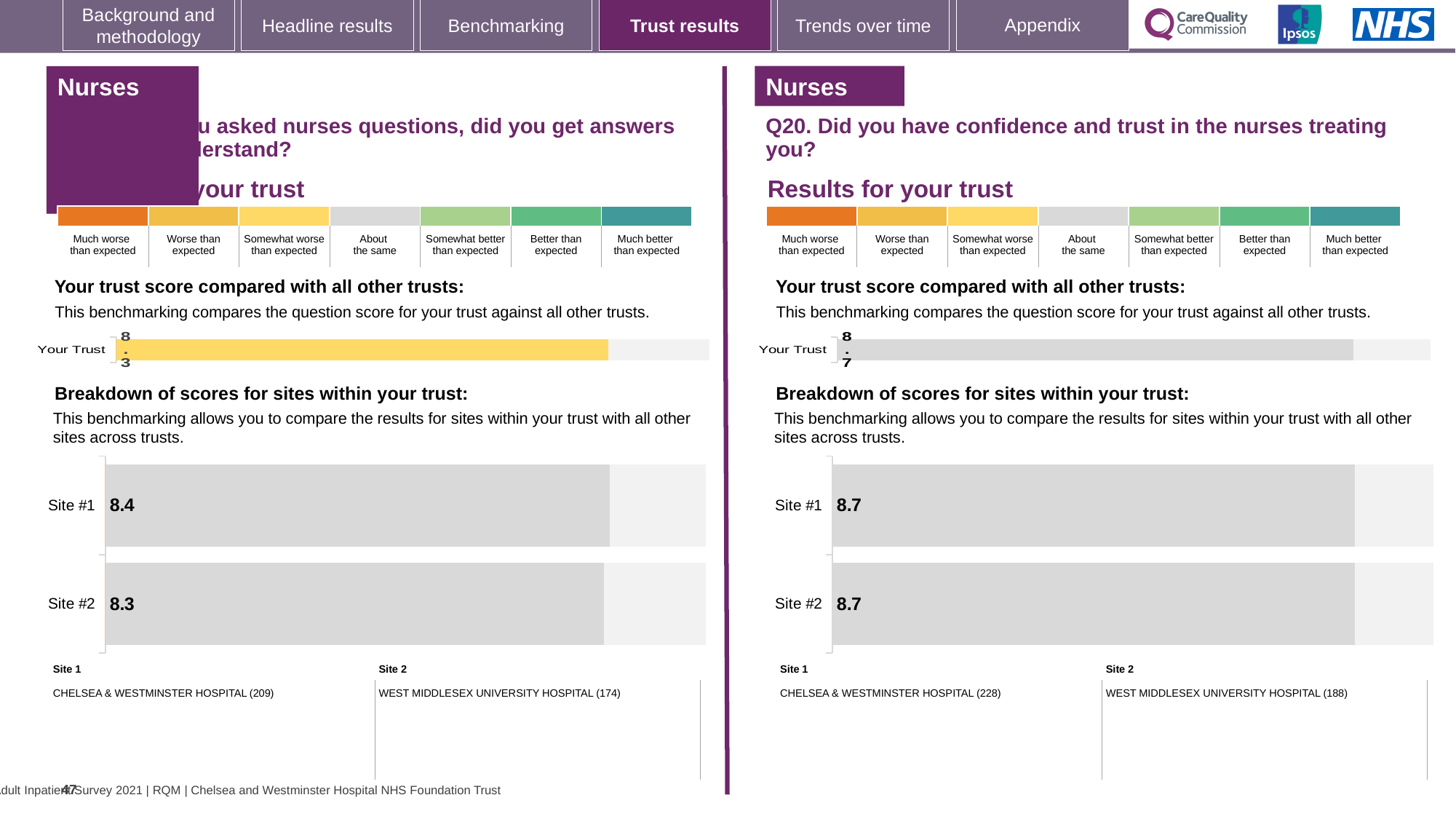
What colour is the Your Trust bar in the left-hand trust score chart? Yellow What type of chart is used for the breakdown of scores for sites on the right half of the slide? Bar chart On the left half of the slide, what is the score shown for Your Trust in the trust score bar chart? 8.3 How many sites are shown in the left-hand breakdown of scores for sites chart? 2 In the left-hand breakdown of scores for sites chart, what is the score for Site #2? 8.3 On the right half of the slide (Q20), what is the score shown for Your Trust in the trust score bar chart? 8.7 In the right-hand (Q20) breakdown of scores for sites chart, what is the difference between the Site #1 and Site #2 scores? 0 In the right-hand (Q20) breakdown of scores for sites chart, what is the score for Site #1? 8.7 In the right-hand (Q20) breakdown of scores for sites chart, what is the score for Site #2? 8.7 In the left-hand breakdown of scores for sites chart, what is the difference between the Site #1 and Site #2 scores? 0.1 In the left-hand breakdown of scores for sites chart, which site has the higher score? Site #1 In the left-hand breakdown of scores for sites chart, what is the score for Site #1? 8.4